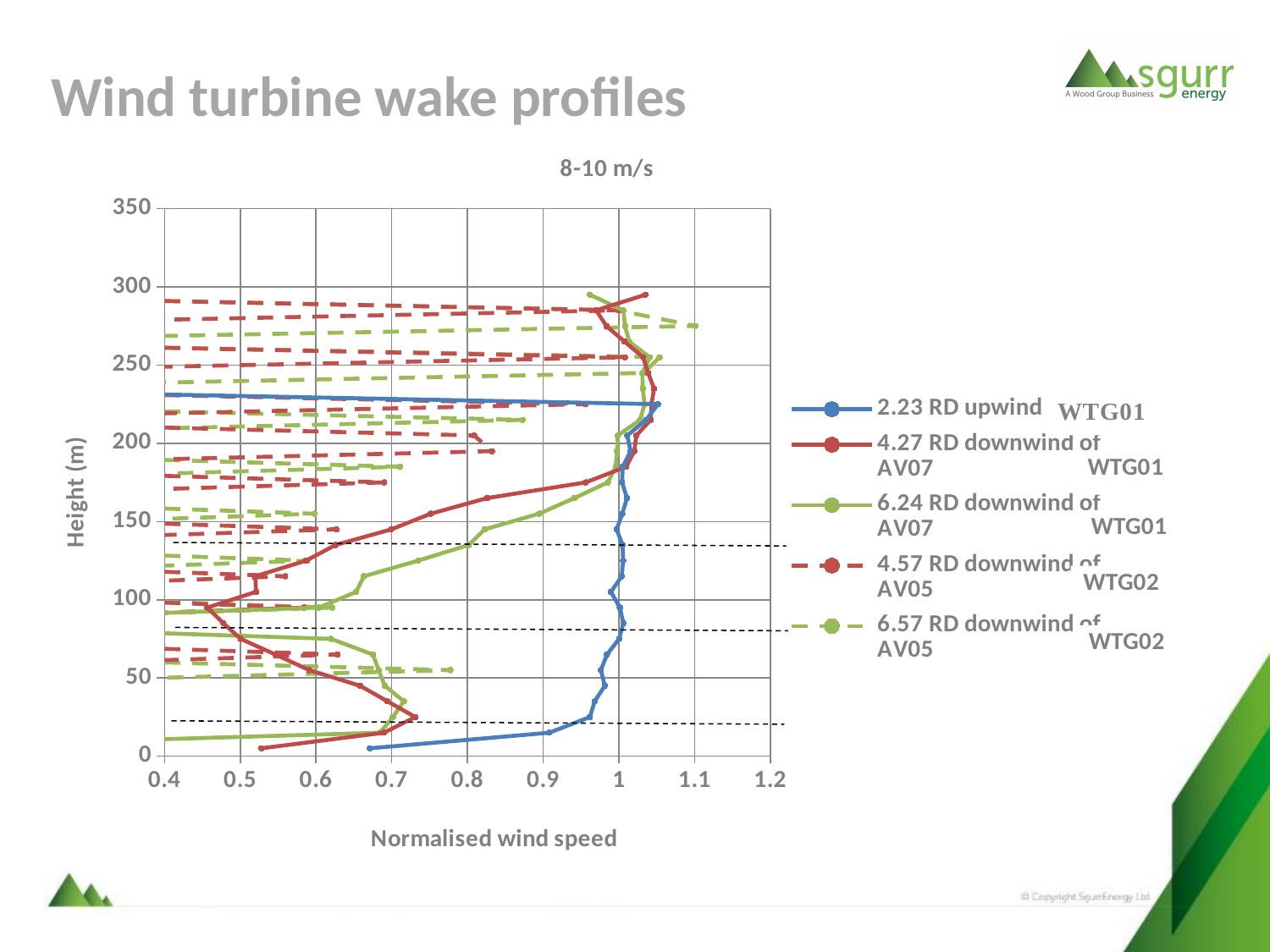
At a height of 100 m, which series has the larger normalised wind speed: 4.27 RD downwind of AV07 or 6.24 RD downwind of AV07? 6.24 RD downwind of AV07 What is the label of the horizontal axis? Normalised wind speed What kind of chart is shown on the slide? line chart Is the normalised wind speed of the 4.27 RD downwind of AV07 series at a height of 100 m greater or less than 0.6? less What is the highest value shown on the horizontal axis? 1.2 What is the title shown above the chart? 8-10 m/s Is the normalised wind speed of the 6.24 RD downwind of AV07 series at a height of 100 m greater or less than 0.5? greater How many series does the legend list? 5 What is the highest value shown on the vertical (Height) axis? 350 For the 2.23 RD upwind series, does the normalised wind speed rise or fall as height increases from 0 m to 100 m? rise At a height of 150 m, which series has the larger normalised wind speed: 2.23 RD upwind or 4.27 RD downwind of AV07? 2.23 RD upwind